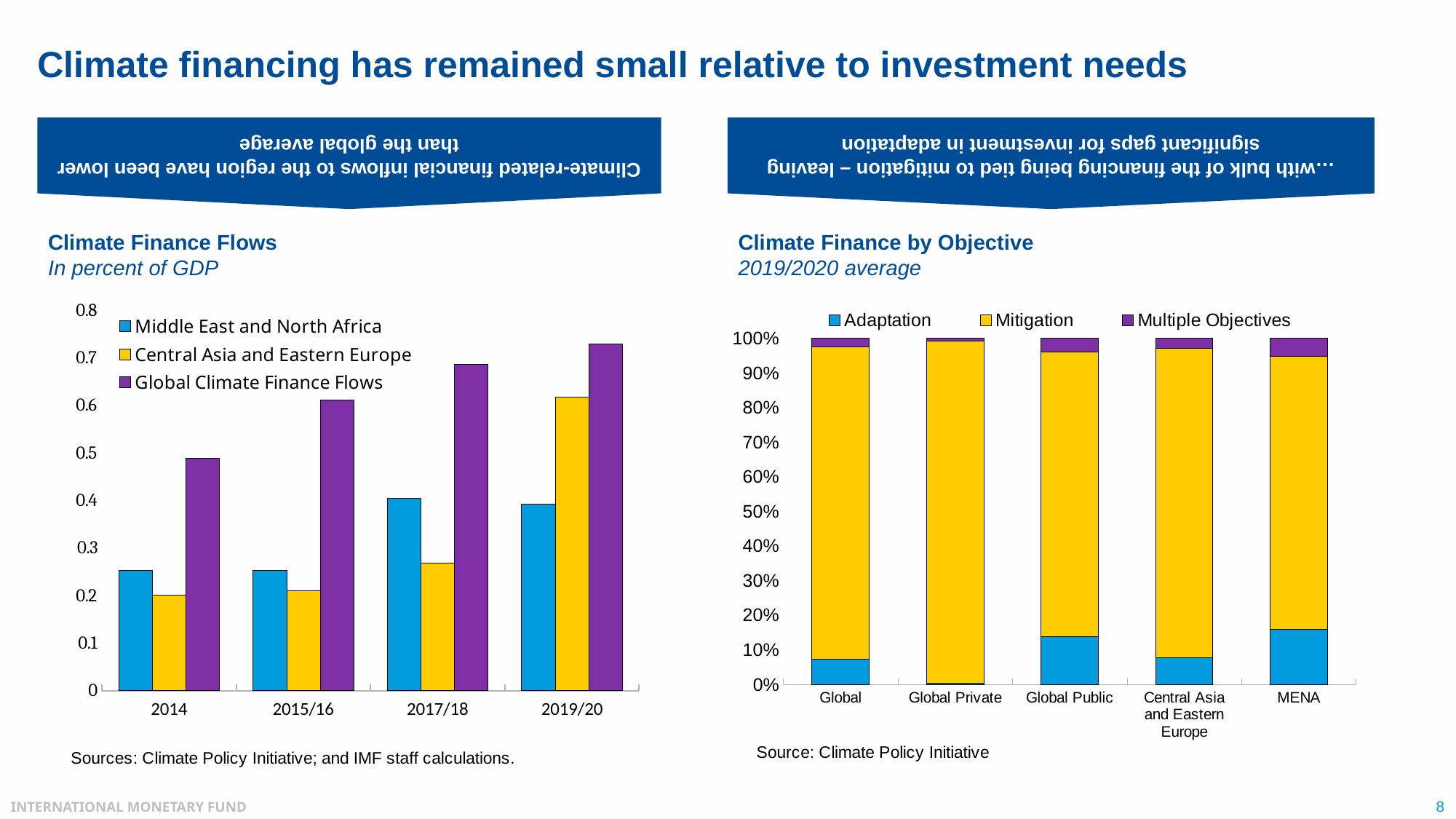
In the 'Climate Finance by Objective' chart, which colour represents Mitigation? yellow How many categories are shown on the x axis of the 'Climate Finance by Objective' chart? 5 In the 'Climate Finance Flows' chart, for 2019/20, which is larger: Middle East and North Africa or Central Asia and Eastern Europe? Central Asia and Eastern Europe In the 'Climate Finance Flows' chart, is the Middle East and North Africa value for 2014 greater or less than 0.3? less In the 'Climate Finance Flows' chart, which period has the highest value for Central Asia and Eastern Europe? 2019/20 In the 'Climate Finance by Objective' chart, which category has the smallest Adaptation share? Global Private How many series does the legend of the 'Climate Finance Flows' chart list? 3 In the 'Climate Finance Flows' chart, is the Global Climate Finance Flows value for 2017/18 greater or less than 0.6? greater In the 'Climate Finance Flows' chart, do the Global Climate Finance Flows values rise or fall from 2014 to 2019/20? rise In the 'Climate Finance by Objective' chart, is the Mitigation share for Global Private greater or less than 90%? greater How many time periods are shown on the x axis of the 'Climate Finance Flows' chart? 4 What type of chart is the 'Climate Finance Flows' chart on the left? bar chart